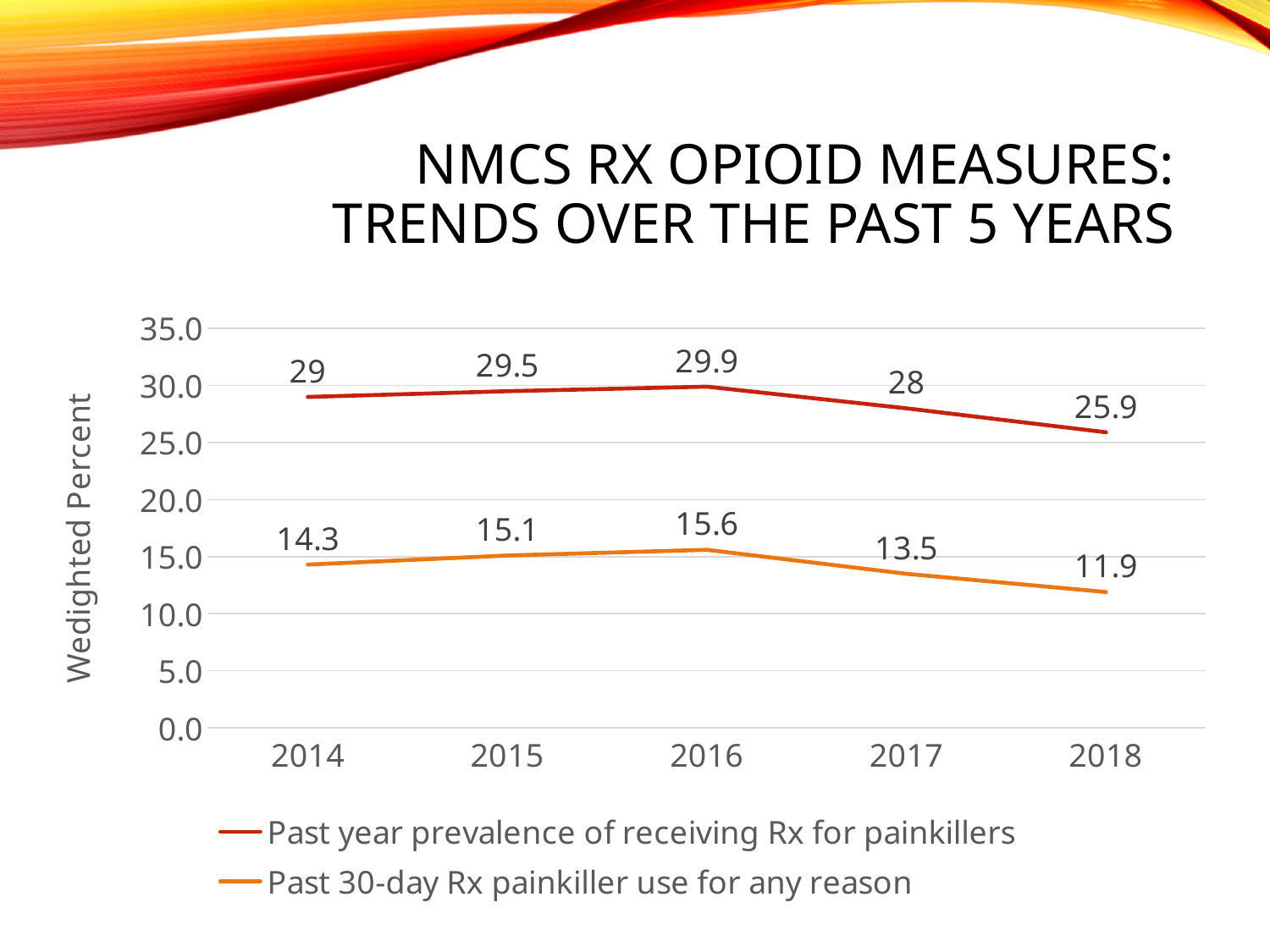
What is the value for 'Past 30-day Rx painkiller use for any reason' in 2018? 11.9 How many series does the legend list? 2 In which year is 'Past year prevalence of receiving Rx for painkillers' highest? 2016 In which year is 'Past 30-day Rx painkiller use for any reason' lowest? 2018 What is the value for 'Past 30-day Rx painkiller use for any reason' in 2014? 14.3 What is the value for 'Past year prevalence of receiving Rx for painkillers' in 2016? 29.9 How many years are shown on the x axis? 5 Which is larger: 'Past 30-day Rx painkiller use for any reason' in 2015 or in 2017? 2015 Is the value for 'Past year prevalence of receiving Rx for painkillers' in 2018 greater or less than 30.0? less What kind of chart is shown on the slide? line chart What is the difference between the two series in 2017? 14.5 What is the difference between the 2016 and 2018 values for 'Past year prevalence of receiving Rx for painkillers'? 4